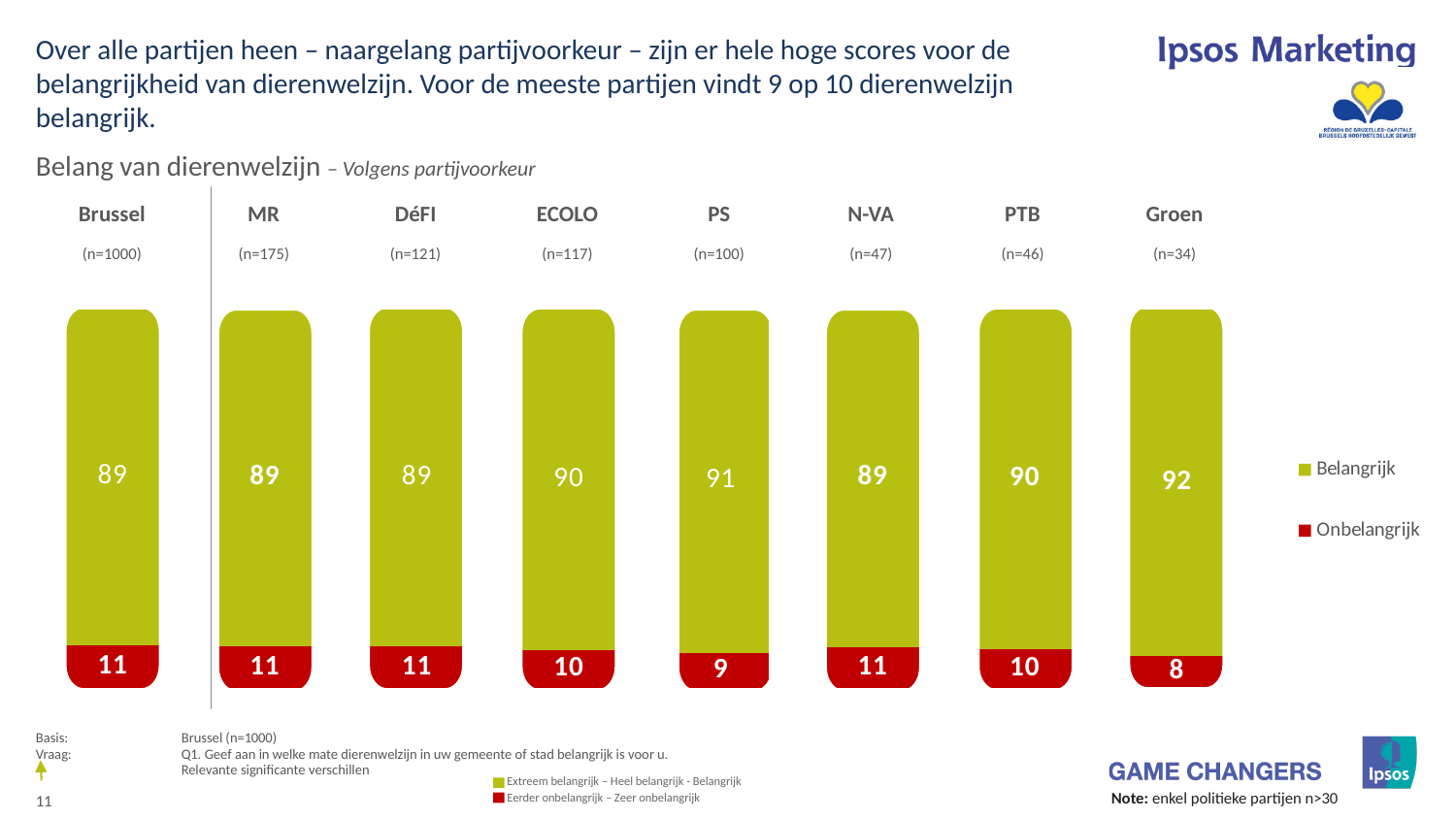
How many series does the legend list? 2 How many categories (parties) are shown in the chart? 8 Which is larger, the Onbelangrijk value for MR or for ECOLO? MR What is the Onbelangrijk value for PS? 9 What is the Belangrijk value for Brussel? 89 Which category has the highest Belangrijk value? Groen What is the Belangrijk value for Groen? 92 What is the total of the stacked bar for PTB? 100 Which category has the lowest Onbelangrijk value? Groen What are the two legend entries of the chart? Belangrijk and Onbelangrijk What is the difference between the Belangrijk values for Groen and Brussel? 3 What kind of chart is shown on the slide? Stacked bar chart